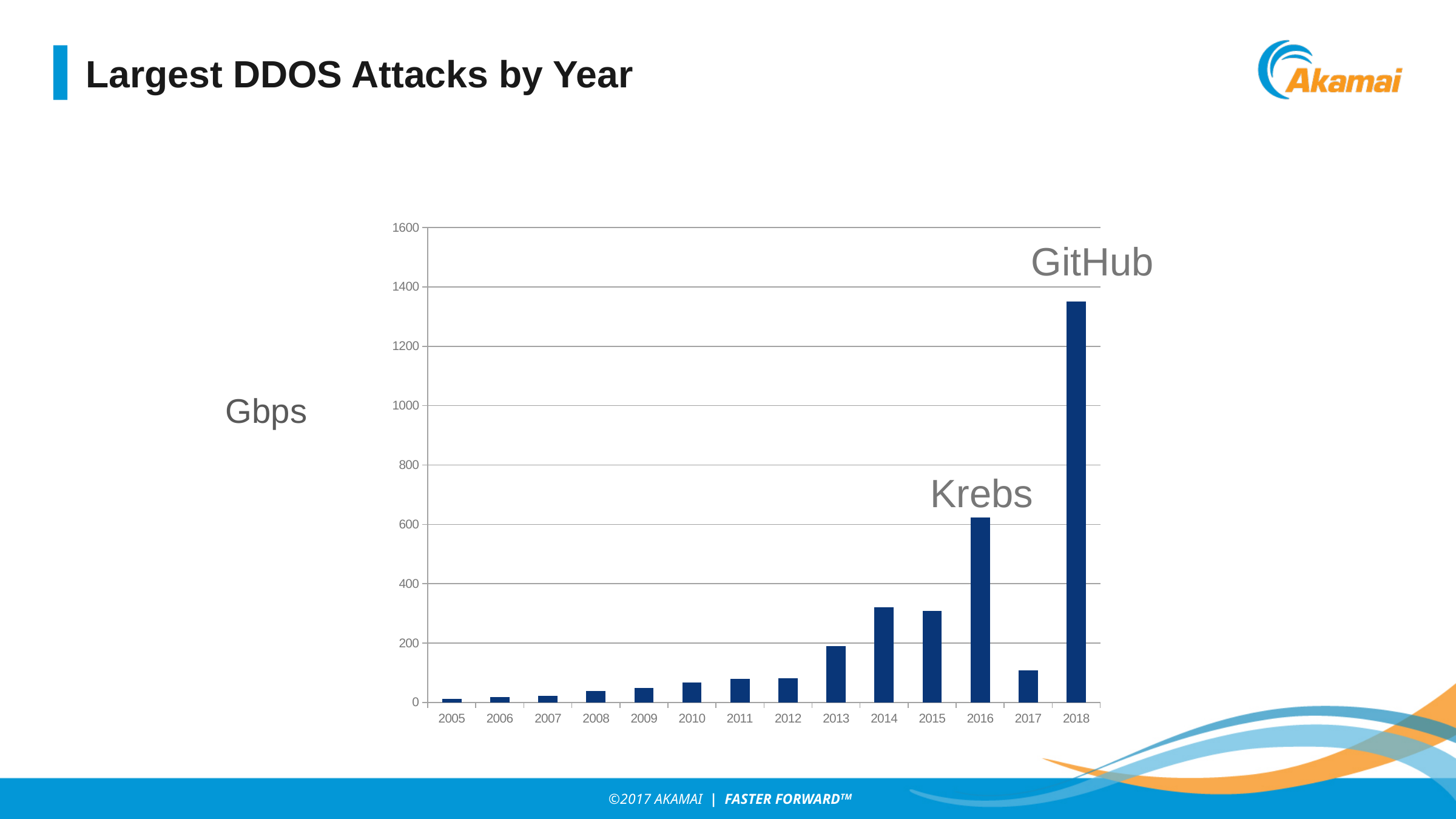
Which year has the larger value, 2013 or 2014? 2014 What kind of chart is shown on the slide? bar chart Is the value for 2016 greater or less than 400? greater How many years are shown on the x axis of the chart? 14 Is the value for 2014 greater or less than 200? greater Is the value for 2017 greater or less than 200? less Which attack name is annotated above the 2016 bar? Krebs Which year has the larger value, 2016 or 2017? 2016 Which year has the lowest value in the chart? 2005 Which year has the highest value in the chart? 2018 Do the values generally rise or fall from 2005 to 2018? rise